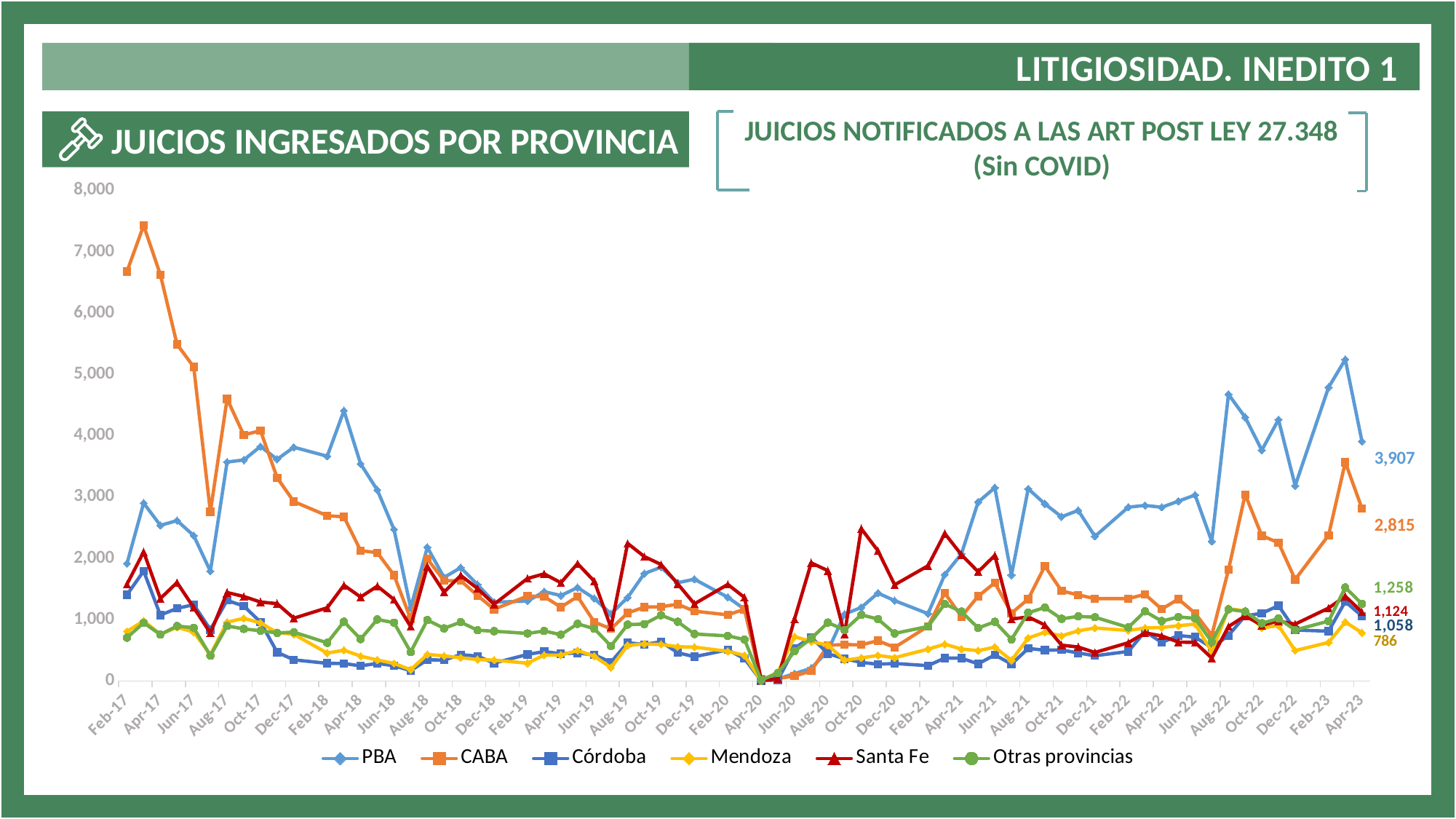
What is the difference between the PBA and CABA values at Apr-23? 1,092 Which series has the highest value at Apr-23? PBA What is the title of the chart? JUICIOS INGRESADOS POR PROVINCIA What kind of chart is shown on the slide? line chart What is the value for PBA at Apr-23? 3,907 At Apr-23, which is larger: Santa Fe or Córdoba? Santa Fe Which series has the lowest value at Apr-23? Mendoza What is the value for Mendoza at Apr-23? 786 Is the value for CABA at Apr-17 greater or less than 7,000? less What is the value for CABA at Apr-23? 2,815 How many series does the legend list? 6 What is the value for Otras provincias at Apr-23? 1,258